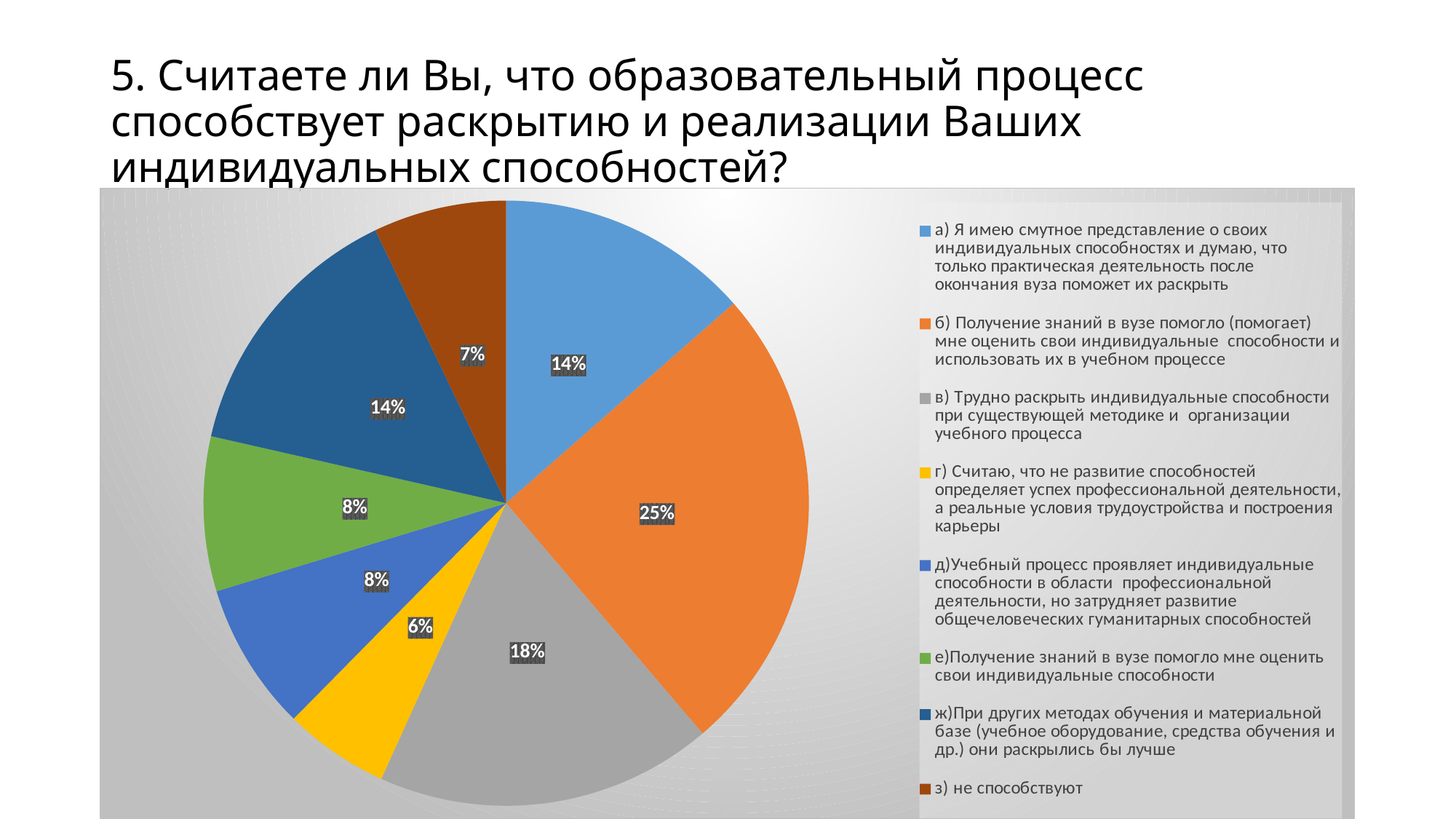
What share of the pie is option б) (Получение знаний в вузе помогло мне оценить свои индивидуальные способности и использовать их в учебном процессе)? 25% How many slices does the pie chart have? 8 How many entries does the legend list? 8 Which option has the largest share of the pie? б) Получение знаний в вузе помогло (помогает) мне оценить свои индивидуальные способности и использовать их в учебном процессе Which is larger: the share for option ж) (При других методах обучения и материальной базе) or the share for option з) (не способствуют)? ж) При других методах обучения и материальной базе What share of the pie is option г) (Считаю, что не развитие способностей определяет успех профессиональной деятельности)? 6% What share of the pie is option в) (Трудно раскрыть индивидуальные способности при существующей методике и организации учебного процесса)? 18% Which option has the smallest share of the pie? г) Считаю, что не развитие способностей определяет успех профессиональной деятельности, а реальные условия трудоустройства и построения карьеры What colour is the slice for option з) (не способствуют)? brown What kind of chart is shown on the slide? pie chart What is the difference in percentage points between option б) (25%) and option в) (18%)? 7